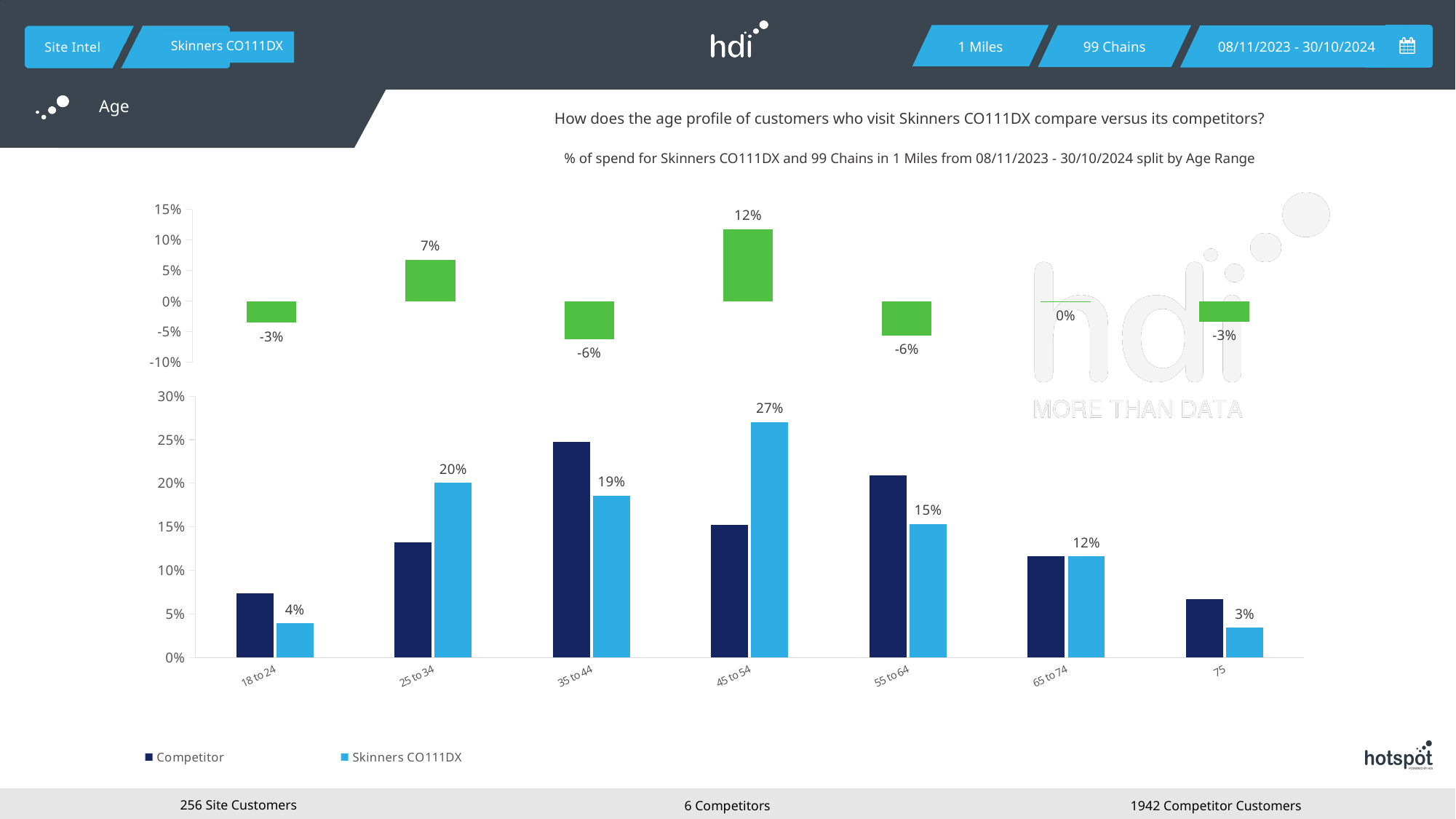
In the top chart, which age range has the highest value? 45 to 54 In the bottom chart, which age range has the highest value for Skinners CO111DX? 45 to 54 In the top chart, what is the value shown for the 65 to 74 age range? 0% In the bottom chart, is the Competitor value for 35 to 44 greater or less than 20%? greater In the bottom chart, what is the value for Skinners CO111DX in the 45 to 54 age range? 27% In the bottom chart, what is the value for Skinners CO111DX in the 18 to 24 age range? 4% In the bottom chart, which age range has the lowest value for Skinners CO111DX? 75 In the bottom chart, what is the difference between the Skinners CO111DX values for 25 to 34 and 55 to 64? 5% How many series does the legend of the bottom chart list? 2 What kind of chart is the bottom chart? bar chart In the bottom chart, which is larger for the 35 to 44 age range: Competitor or Skinners CO111DX? Competitor In the top chart, what is the value shown for the 25 to 34 age range? 7%